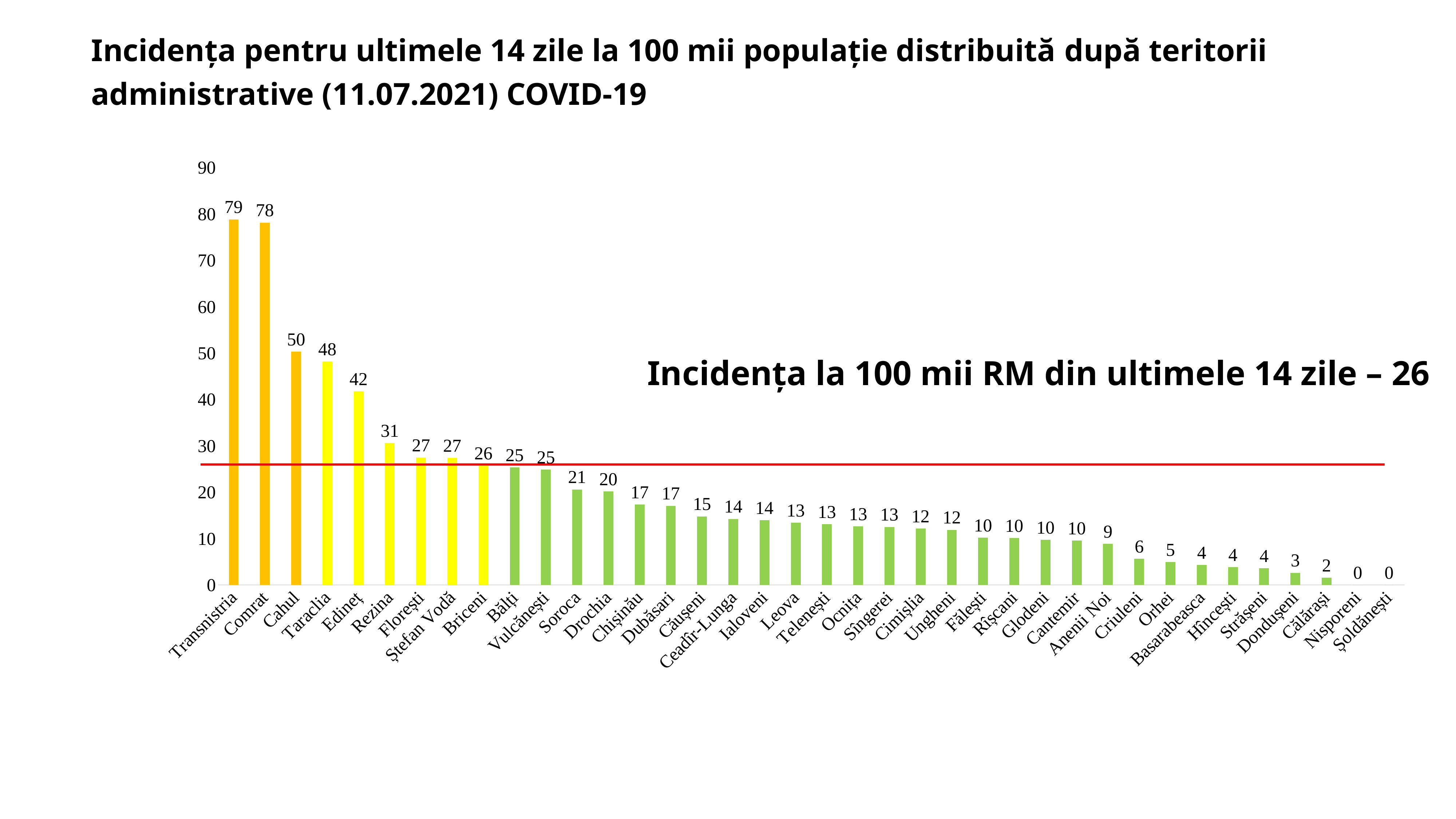
Do the values rise or fall from left to right along the x axis? fall What is the difference between the incidence values for Taraclia and Edineț? 6 What is the incidence value for Bălți? 25 How many territories are shown on the x axis? 38 What national incidence value for the last 14 days is stated in the text on the slide? 26 Which has a higher incidence, Orhei or Criuleni? Criuleni What is the difference between the incidence values for Transnistria and Comrat? 1 What is the incidence value for Chișinău? 17 What is the incidence value for Cahul? 50 Which has a higher incidence, Rezina or Soroca? Rezina What kind of chart is shown on the slide? bar chart Which territory has the highest incidence? Transnistria